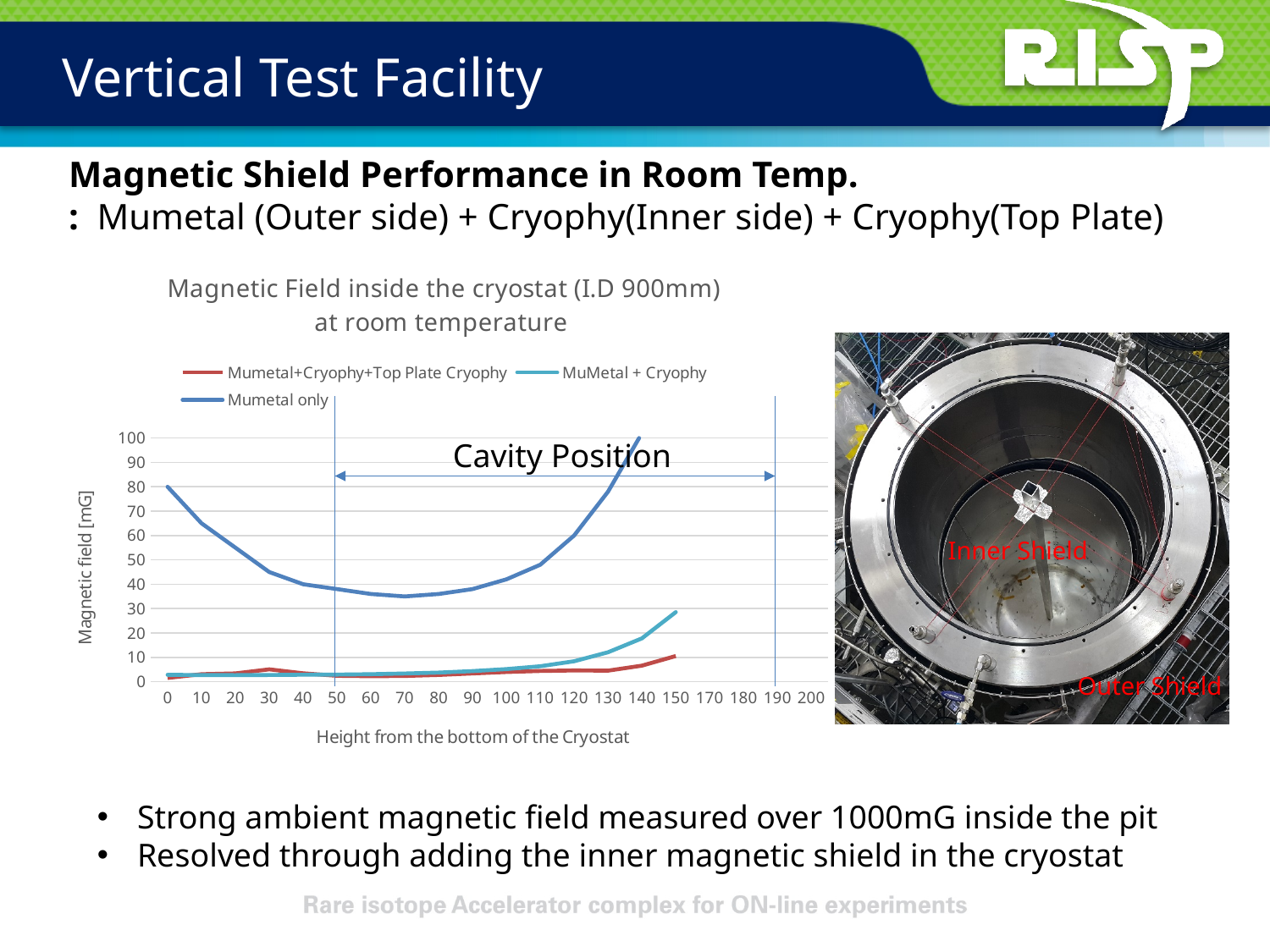
Is the value of the MuMetal + Cryophy series at height 150 greater or less than 20? greater What is the title of the chart? Magnetic Field inside the cryostat (I.D 900mm) at room temperature At height 150, which series has the larger value: MuMetal + Cryophy or Mumetal+Cryophy+Top Plate Cryophy? MuMetal + Cryophy Is the value of the Mumetal only series at height 70 greater or less than 50? less Is the value of the Mumetal only series at height 140 greater or less than 80? greater What is the label of the vertical axis of the chart? Magnetic field [mG] How many series does the chart legend list? 3 What kind of chart is shown on the slide? line chart Which series has the highest magnetic field values across the chart? Mumetal only Does the Mumetal only series rise or fall between height 0 and height 70? fall